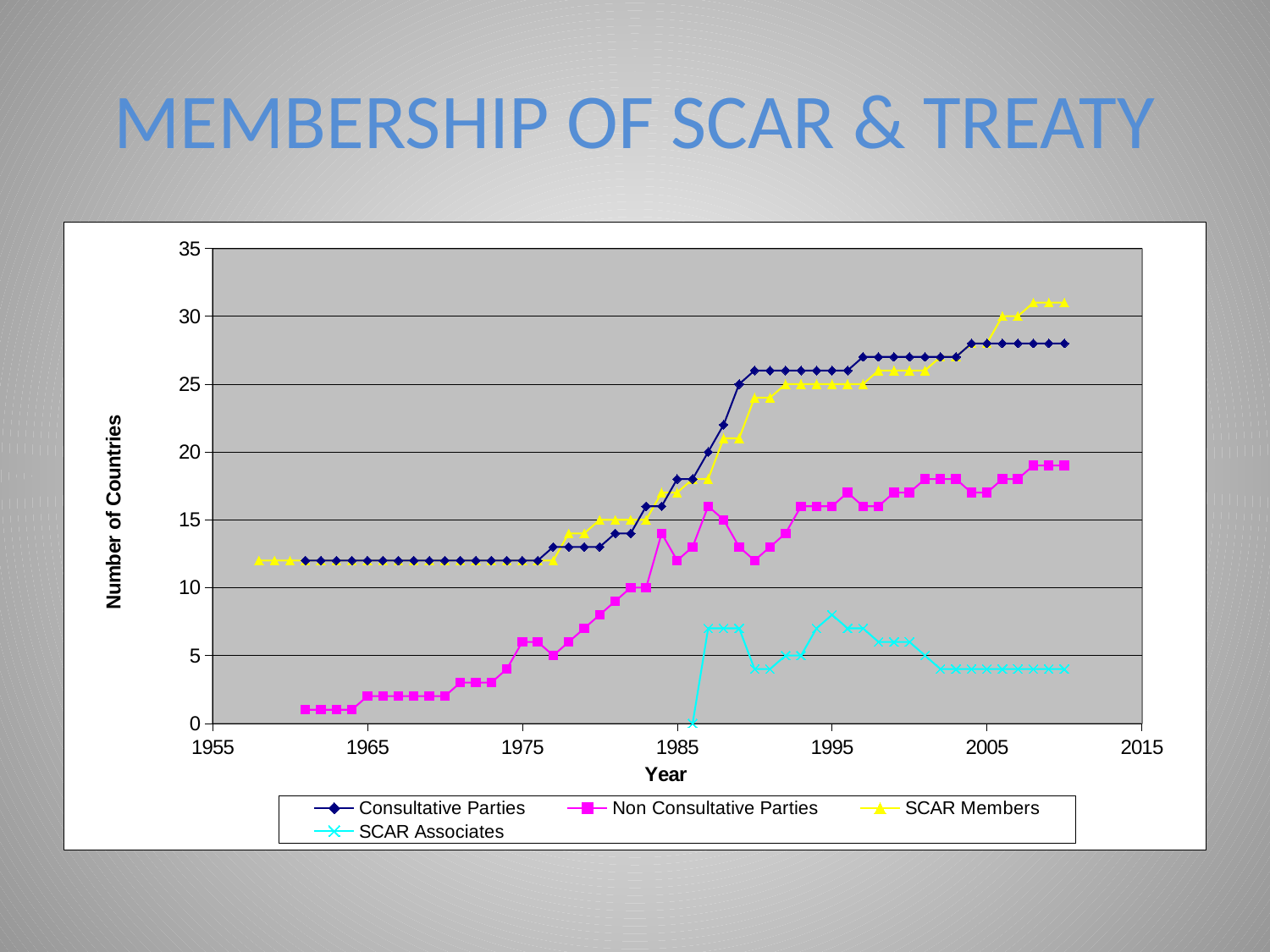
Is the value for Non Consultative Parties in 2010 greater or less than 15? greater Is the value for SCAR Associates in 2010 greater or less than 5? less Do the values for Consultative Parties generally rise or fall from 1965 to 2010? rise In 1985, which is larger: Consultative Parties or Non Consultative Parties? Consultative Parties What is the title of the chart? MEMBERSHIP OF SCAR & TREATY What is the label on the vertical axis? Number of Countries Is the value for Non Consultative Parties in 1965 greater or less than 5? less How many series does the legend list? 4 Which series has the lowest value in 2010? SCAR Associates What kind of chart is shown on the slide? line chart Which series has the highest value in 2010? SCAR Members